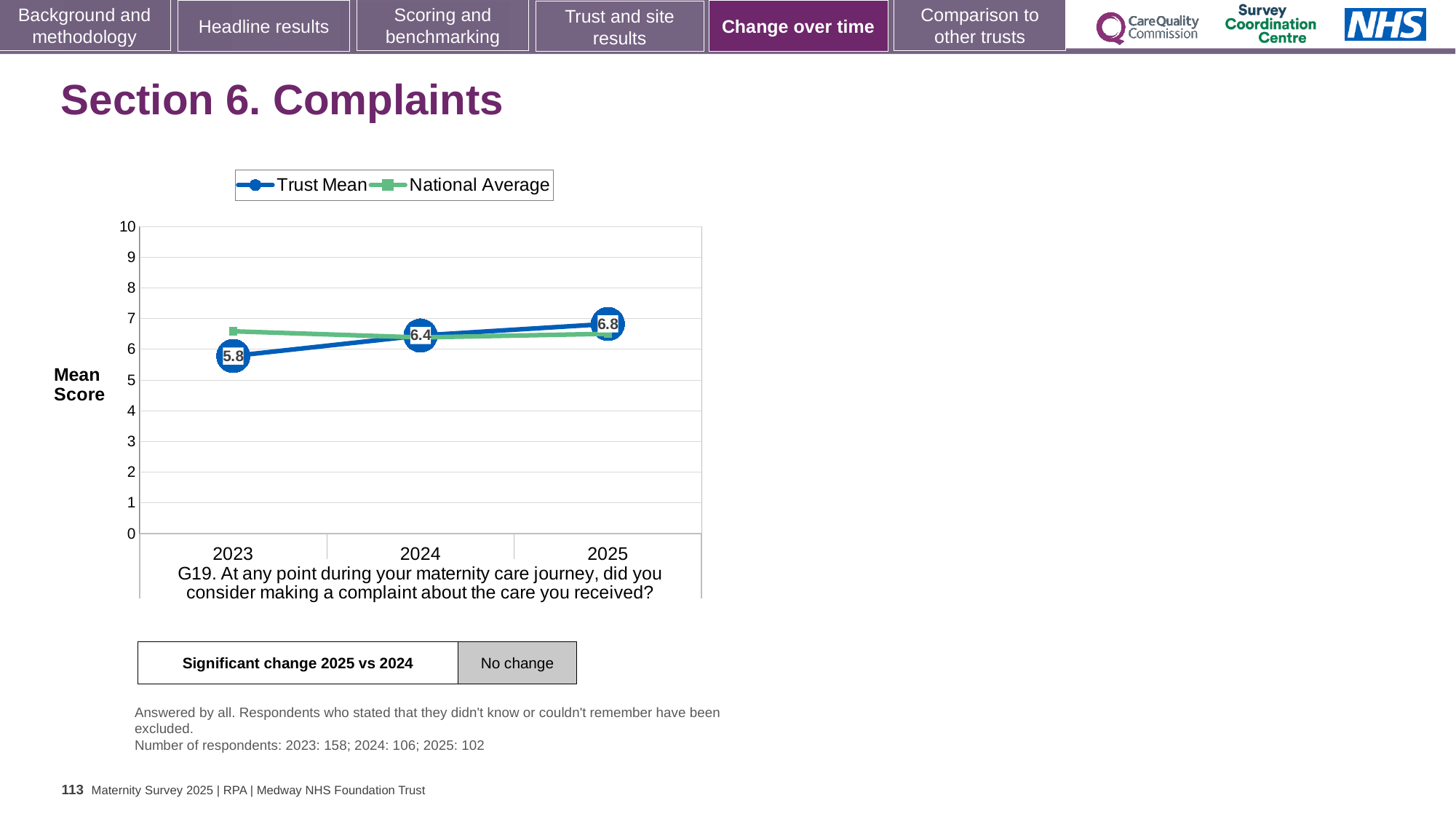
What is the Trust Mean score for 2024? 6.4 What is the difference between the Trust Mean score in 2025 and in 2023? 1.0 In 2023, which is higher: the Trust Mean or the National Average? National Average What is the Trust Mean score for 2025? 6.8 How many series does the chart legend list? 2 Is the National Average value for 2023 greater or less than 6? greater What kind of chart is shown on the slide? line chart In which year is the Trust Mean score highest? 2025 Does the Trust Mean rise or fall from 2023 to 2025? rise How many years are shown on the x axis of the chart? 3 In which year is the Trust Mean score lowest? 2023 What is the Trust Mean score for 2023? 5.8